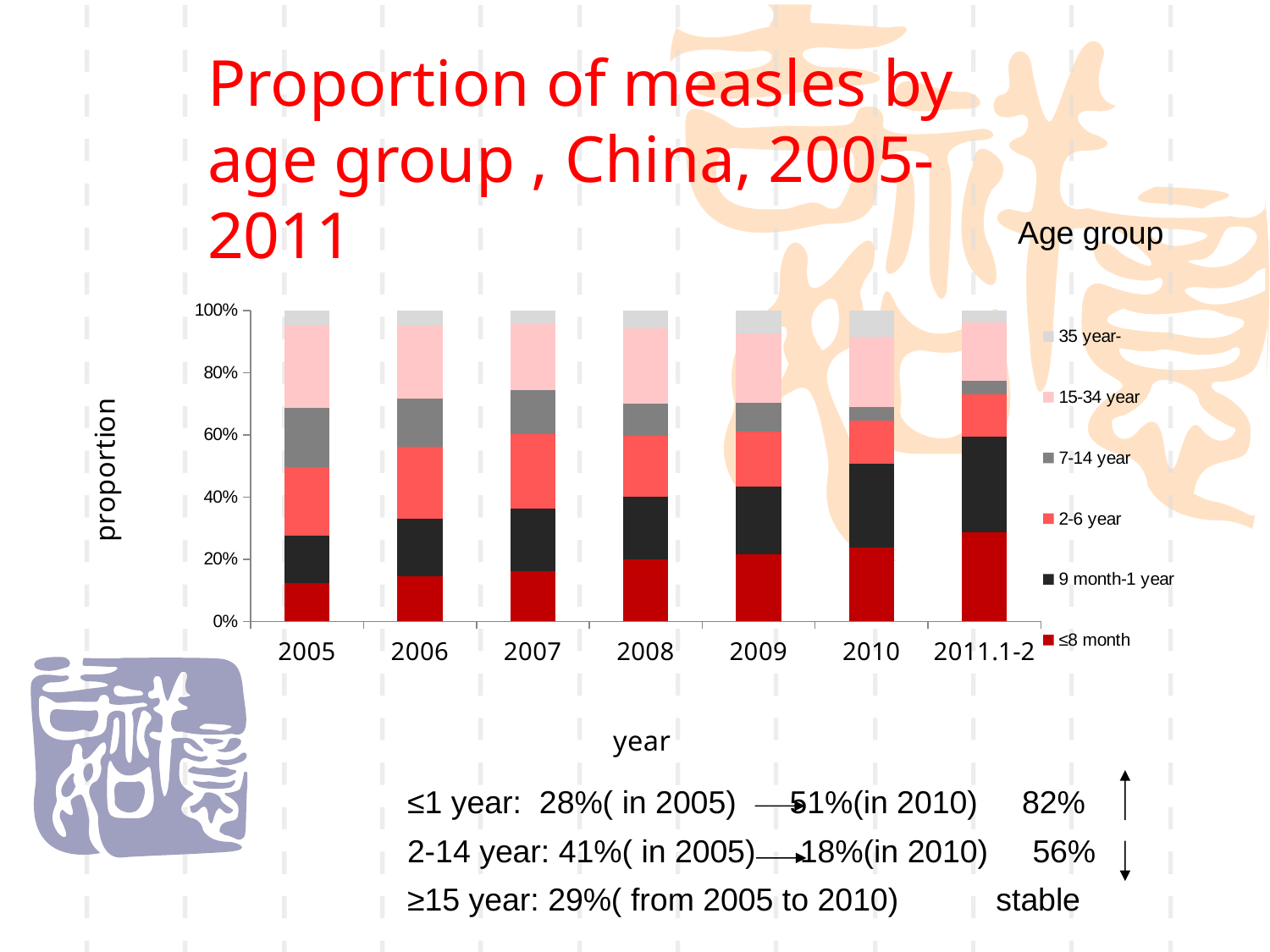
What is the label on the vertical axis of the chart? proportion How many year categories are shown along the x axis of the chart? 7 How many age-group series does the chart legend list? 6 What is the title shown above the chart legend? Age group Is the ≤8 month proportion larger in 2005 or in 2010? 2010 Is the ≤8 month proportion for 2005 greater or less than 20%? less Which year has the smallest ≤8 month proportion? 2005 What kind of chart is shown on the slide? bar chart In 2010, does the top of the 9 month-1 year segment sit above or below the 40% gridline? above Which year has the largest ≤8 month proportion? 2011.1-2 Is the ≤8 month proportion for 2011.1-2 greater or less than 20%? greater Does the ≤8 month proportion rise or fall from 2005 to 2011.1-2? rises